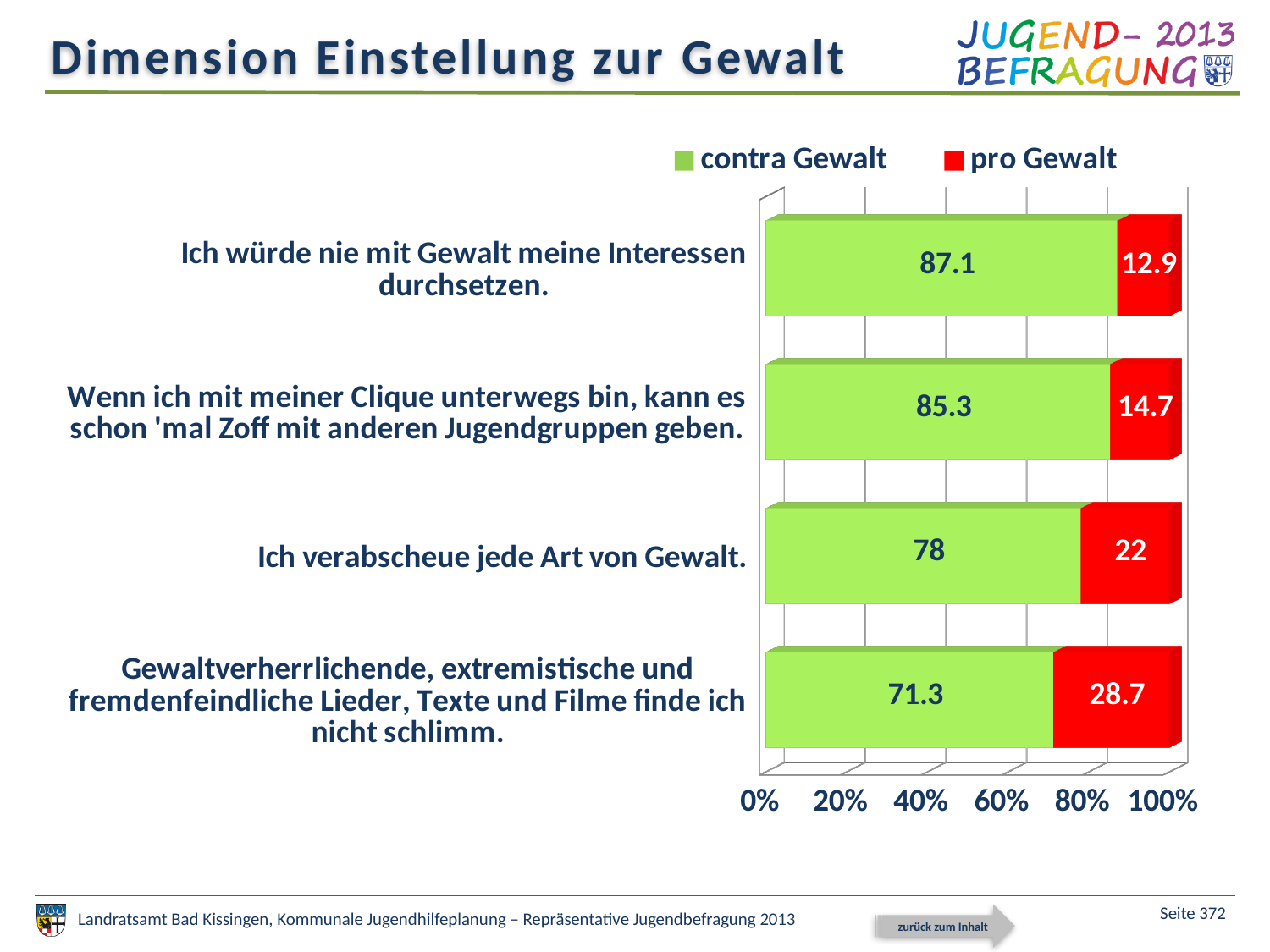
What is the 'contra Gewalt' value for 'Ich würde nie mit Gewalt meine Interessen durchsetzen.'? 87.1 Which statement has the lowest 'pro Gewalt' value? Ich würde nie mit Gewalt meine Interessen durchsetzen. What kind of chart is shown on the slide? Stacked bar chart Which colour represents 'pro Gewalt' in the chart? Red What is the 'pro Gewalt' value for 'Gewaltverherrlichende, extremistische und fremdenfeindliche Lieder, Texte und Filme finde ich nicht schlimm.'? 28.7 What is the total of the stacked bar for 'Wenn ich mit meiner Clique unterwegs bin, kann es schon 'mal Zoff mit anderen Jugendgruppen geben.'? 100 Which is larger: the 'contra Gewalt' value for 'Wenn ich mit meiner Clique unterwegs bin, kann es schon 'mal Zoff mit anderen Jugendgruppen geben.' or for 'Ich verabscheue jede Art von Gewalt.'? Wenn ich mit meiner Clique unterwegs bin, kann es schon 'mal Zoff mit anderen Jugendgruppen geben. What is the difference between the 'pro Gewalt' values for 'Gewaltverherrlichende, extremistische und fremdenfeindliche Lieder, Texte und Filme finde ich nicht schlimm.' and 'Ich verabscheue jede Art von Gewalt.'? 6.7 What is the 'pro Gewalt' value for 'Ich verabscheue jede Art von Gewalt.'? 22 How many statements (categories) are shown in the chart? 4 How many series does the legend list? 2 Which statement has the highest 'contra Gewalt' value? Ich würde nie mit Gewalt meine Interessen durchsetzen.